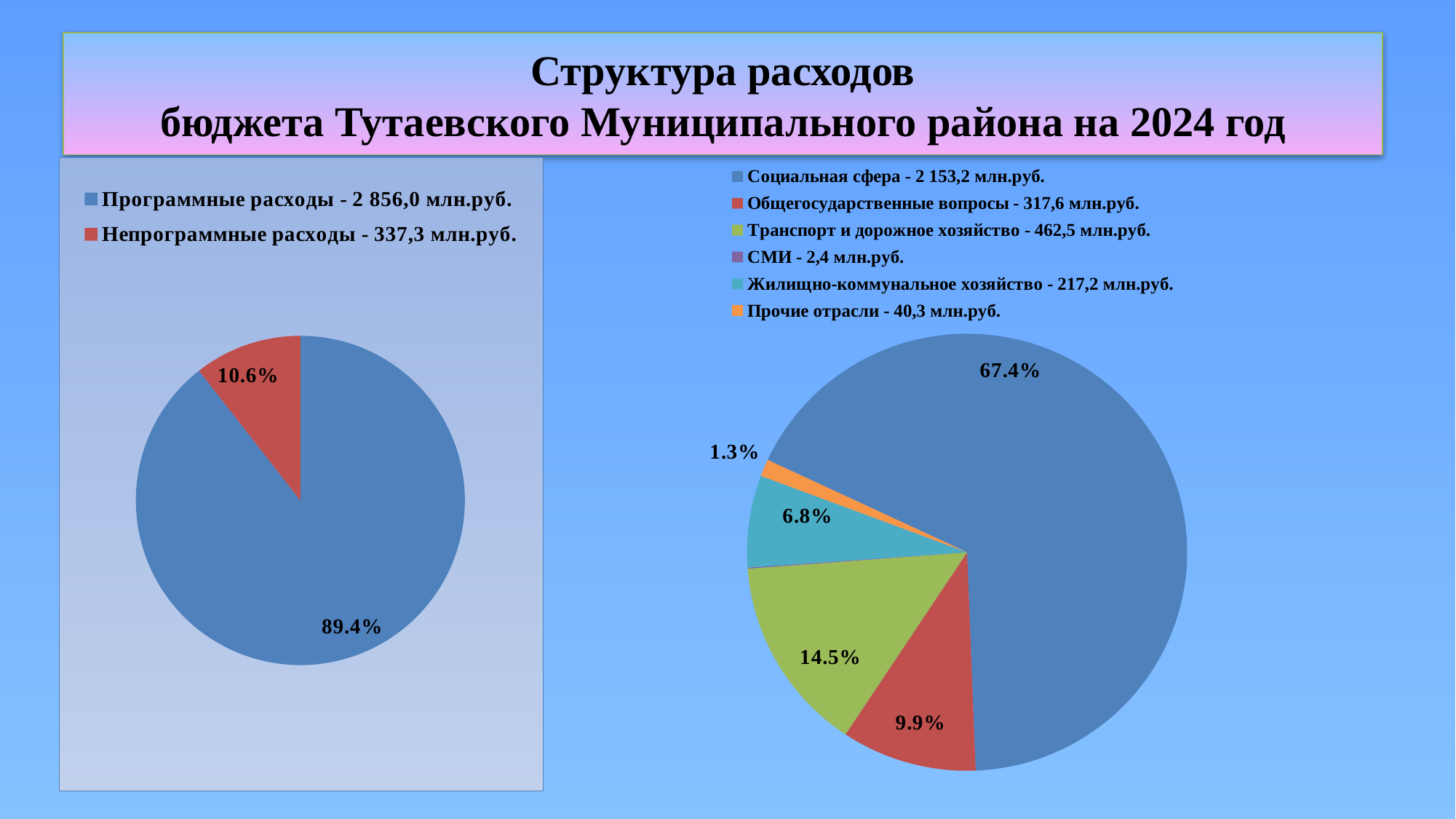
In the right pie chart, which category has the smallest slice? СМИ In the right pie chart, what share does Жилищно-коммунальное хозяйство have? 6.8% What type of chart is the left chart on the slide? pie chart How many categories does the right chart's legend list? 6 In the right pie chart, which category has the largest slice? Социальная сфера In the left pie chart, what share does Программные расходы have? 89.4% In the left chart's legend, what amount is given for Непрограммные расходы? 337,3 млн.руб. In the right pie chart, what share does Транспорт и дорожное хозяйство have? 14.5% How many slices does the left pie chart have? 2 In the right chart's legend, what amount is given for Общегосударственные вопросы? 317,6 млн.руб.